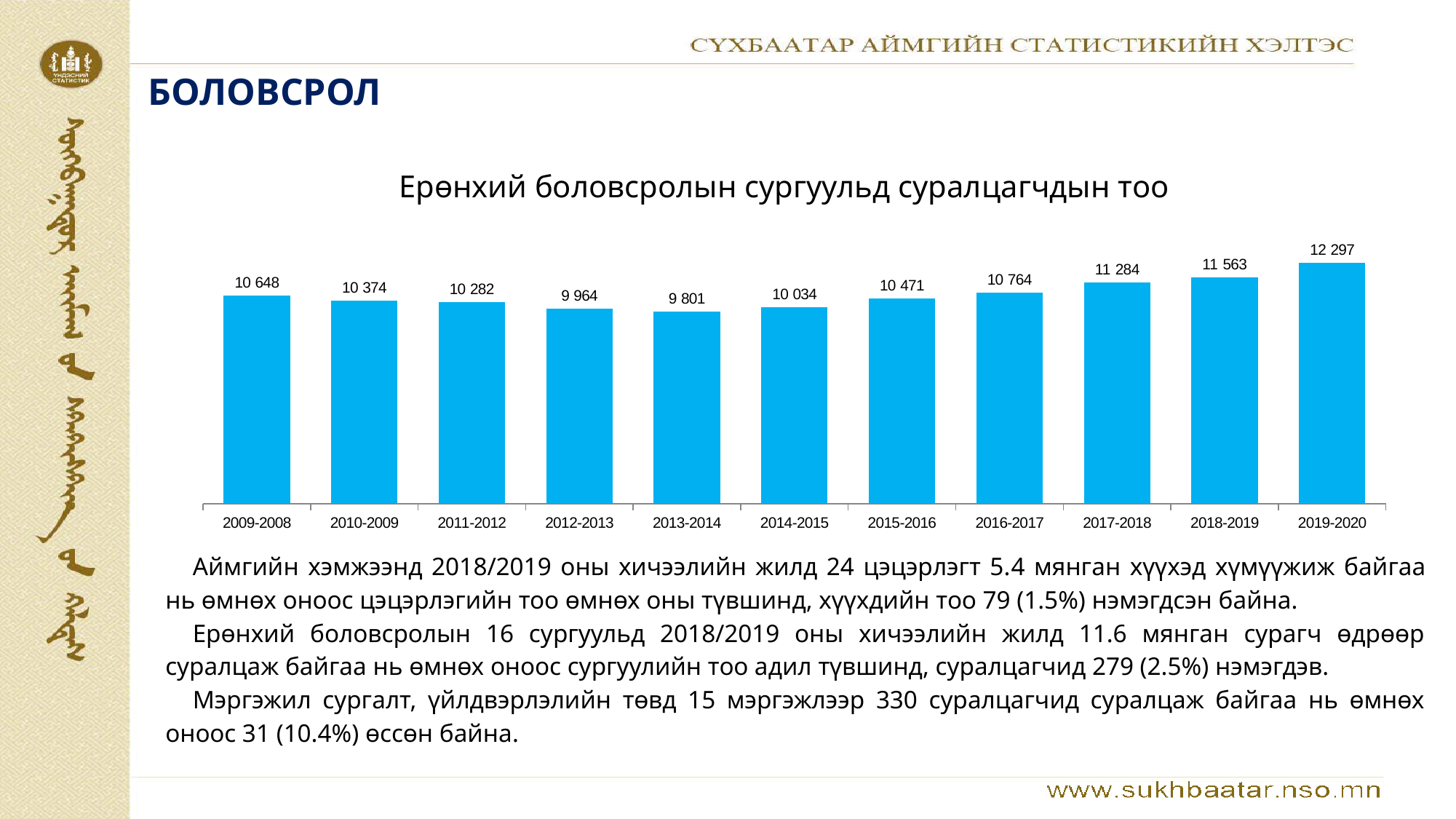
What is the difference between the values for 2009-2008 and 2013-2014? 847 What is the value for 2016-2017 in the chart? 10 764 What is the difference between the values for 2019-2020 and 2018-2019? 734 How many categories are shown on the x axis of the chart? 11 Do the values rise or fall from 2013-2014 to 2019-2020? rise Which is larger, the value for 2010-2009 or the value for 2015-2016? 2015-2016 Which category has the highest value in the chart? 2019-2020 Which category has the lowest value in the chart? 2013-2014 What kind of chart is shown on the slide? bar chart What is the title of the chart on the slide? Ерөнхий боловсролын сургуульд суралцагчдын тоо What is the value for 2019-2020 in the chart "Ерөнхий боловсролын сургуульд суралцагчдын тоо"? 12 297 What is the value for 2013-2014 in the chart? 9 801